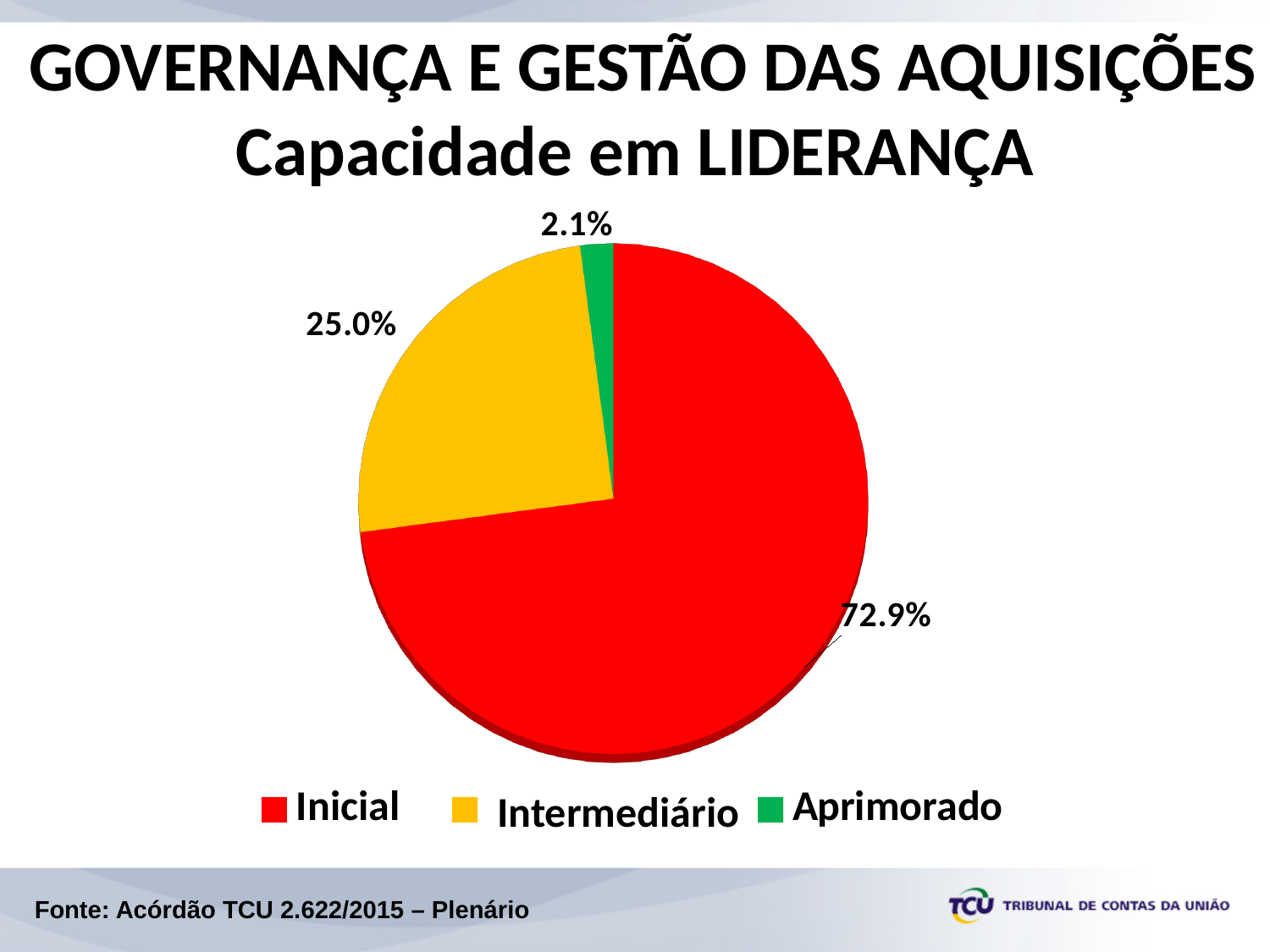
How many entries does the legend list? 3 Which is larger, the share for Intermediário or the share for Aprimorado? Intermediário Which category has the smallest slice of the pie? Aprimorado How many slices does the pie chart have? 3 Which category has the largest slice of the pie? Inicial What colour is the Inicial slice? red What share of the pie does Aprimorado represent? 2.1% What is the difference in percentage points between Intermediário and Aprimorado? 22.9 What is the difference in percentage points between Inicial and Intermediário? 47.9 What share of the pie does Intermediário represent? 25.0% What kind of chart is shown on the slide? pie chart What share of the pie does Inicial represent? 72.9%